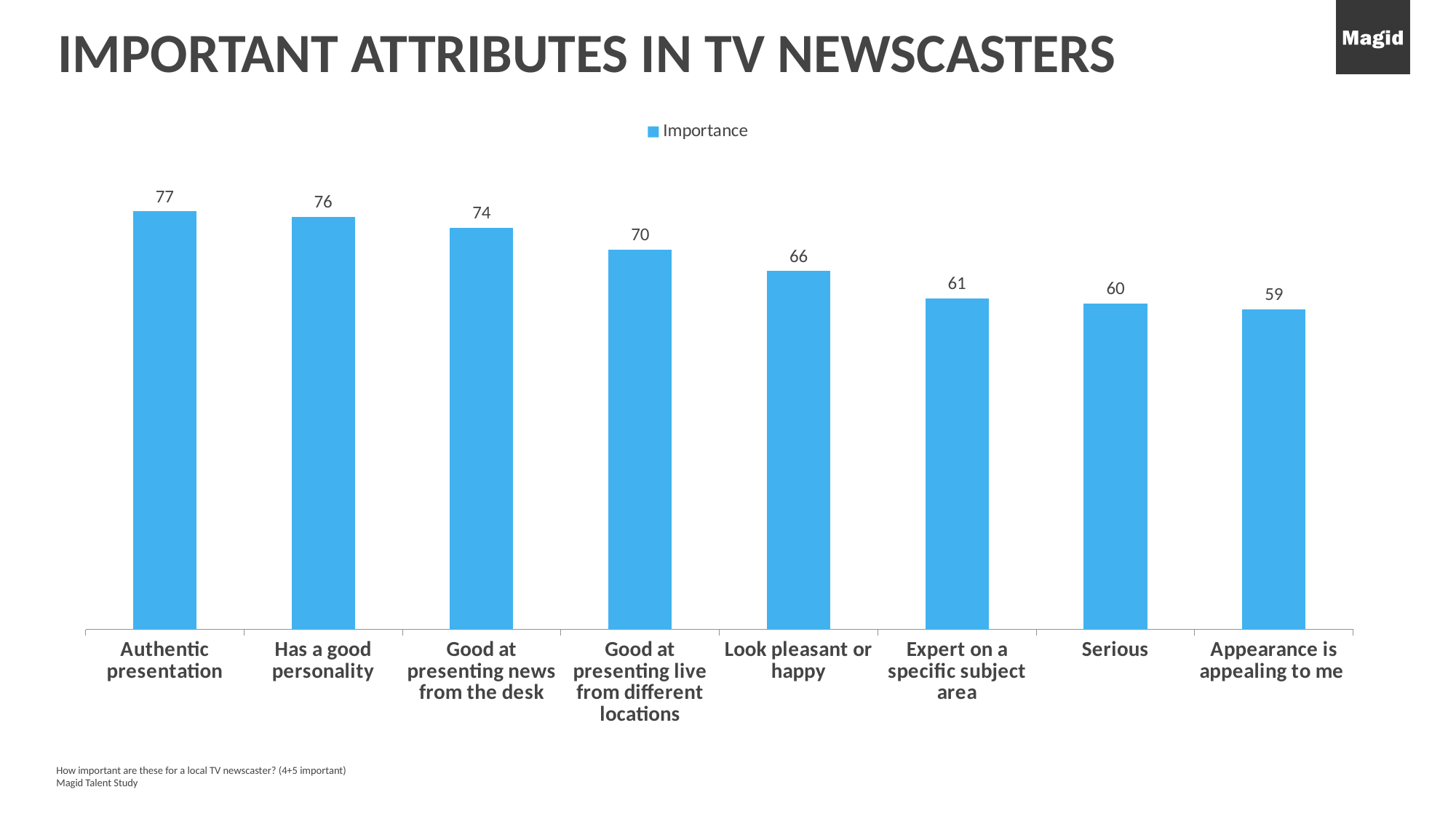
How many series does the legend list? 1 Which attribute has the highest Importance value? Authentic presentation What is the Importance value for Authentic presentation? 77 Which attribute has the lowest Importance value? Appearance is appealing to me What is the Importance value for Good at presenting live from different locations? 70 Which has a higher Importance value, Has a good personality or Expert on a specific subject area? Has a good personality What is the difference between the Importance values for Good at presenting news from the desk and Look pleasant or happy? 8 Do the Importance values rise or fall from left to right across the chart? Fall What kind of chart is shown on the slide? Bar chart What is the Importance value for Serious? 60 How many attributes are shown in the chart? 8 What is the difference between the Importance values for Authentic presentation and Appearance is appealing to me? 18